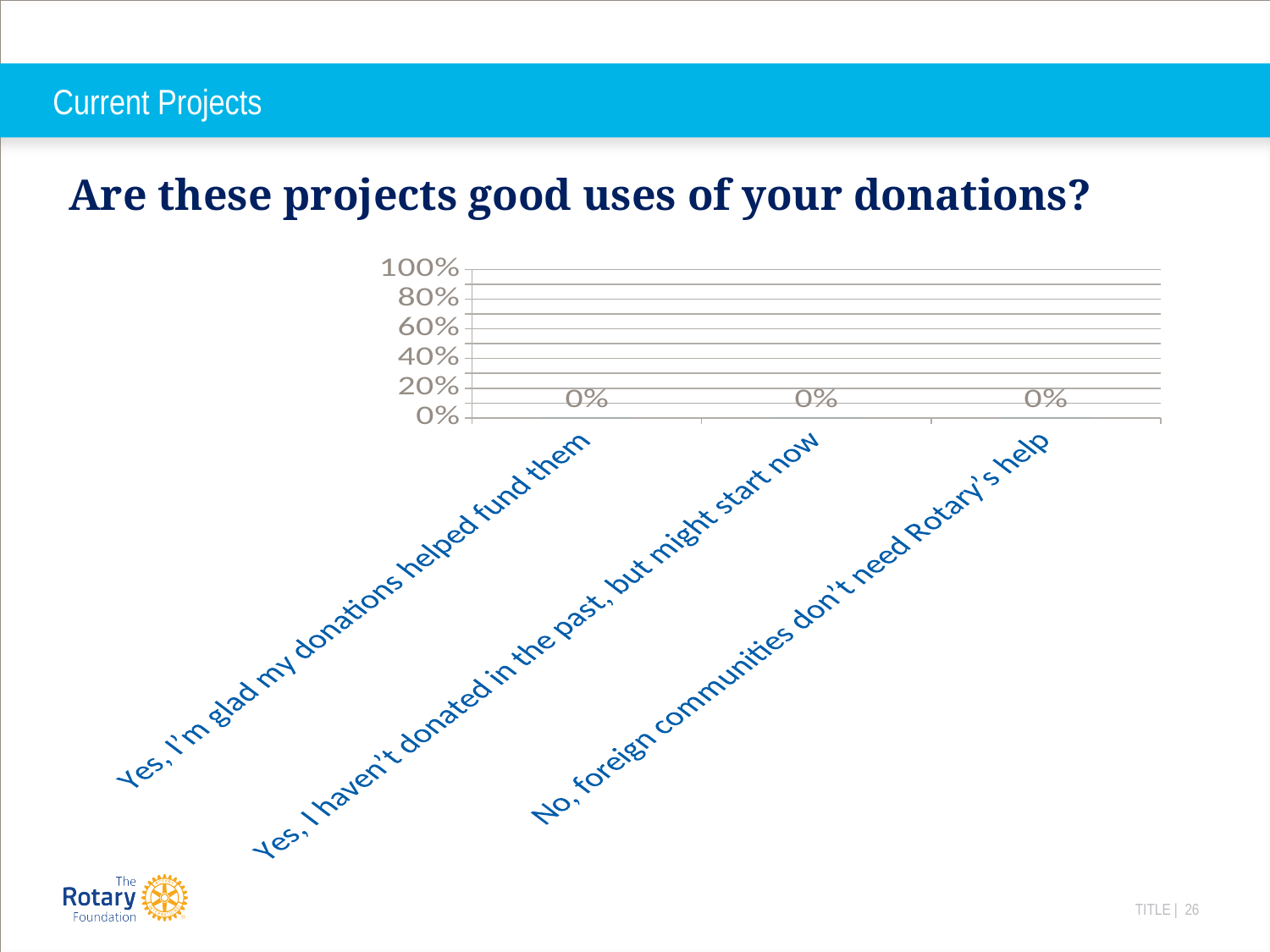
What is the difference between the values for "Yes, I'm glad my donations helped fund them" and "No, foreign communities don't need Rotary's help"? 0% Is the value for "No, foreign communities don't need Rotary's help" greater or less than 40%? less What question does the slide heading above the chart ask? Are these projects good uses of your donations? What value is shown for "Yes, I'm glad my donations helped fund them"? 0% What value is shown for "Yes, I haven't donated in the past, but might start now"? 0% What is the highest value shown on the y axis of the chart? 100% Is the value for "Yes, I haven't donated in the past, but might start now" greater or less than 20%? less How many categories are shown on the x axis of the chart? 3 What kind of chart is shown on the slide? bar chart What value is shown for "No, foreign communities don't need Rotary's help"? 0%